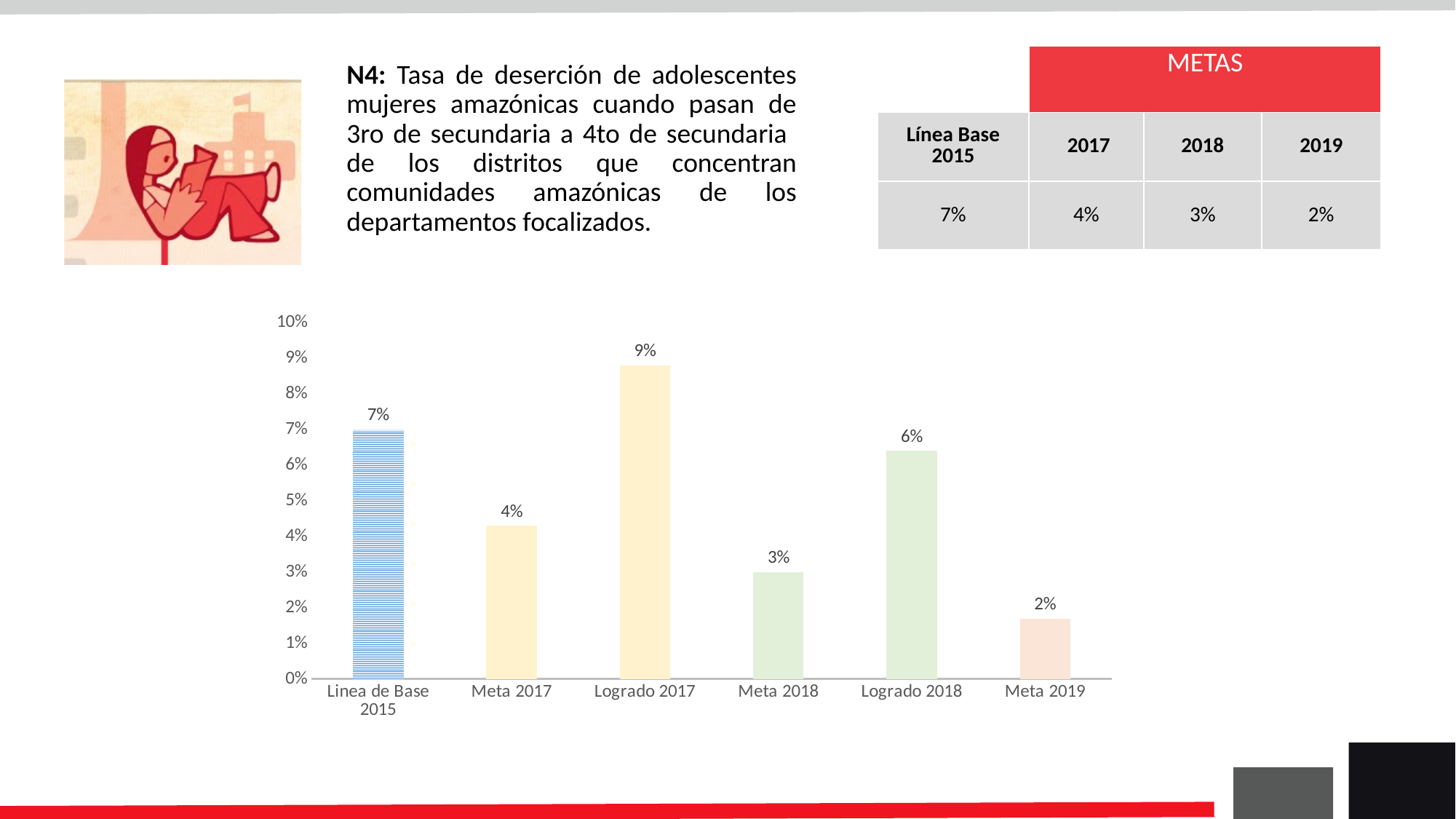
Which category has the highest value? Logrado 2017 What is the difference between Logrado 2018 and Meta 2018? 3% What kind of chart is shown on the slide? Bar chart What is the value for Linea de Base 2015? 7% What is the value for Logrado 2017? 9% What is the value for Meta 2019? 2% What is the value for Logrado 2018? 6% What is the maximum value shown on the y axis? 10% What is the difference between Logrado 2017 and Meta 2017? 5% Which is larger, Meta 2017 or Logrado 2018? Logrado 2018 Which category has the lowest value? Meta 2019 How many categories are shown on the x axis? 6